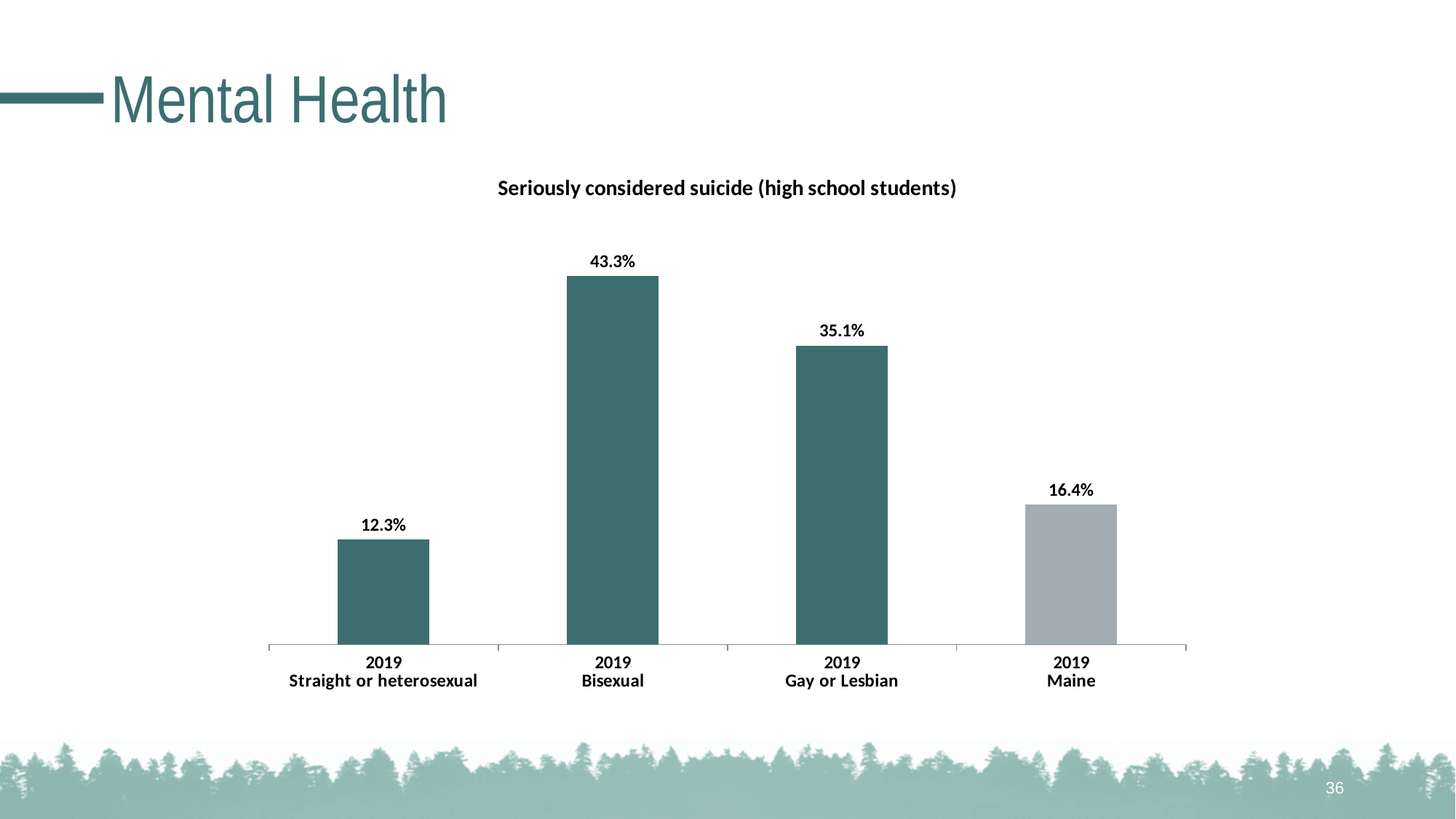
Which category has the highest value? Bisexual What is the difference between the Bisexual and Gay or Lesbian values? 8.2% How many bars are shown in the chart? 4 What is the value for Straight or heterosexual students? 12.3% What kind of chart is shown on the slide? Bar chart What is the value for Maine overall? 16.4% Which is larger, the value for Gay or Lesbian or the value for Maine? Gay or Lesbian What is the difference between the Maine value and the Straight or heterosexual value? 4.1% What is the value for Bisexual students in the chart? 43.3% What is the title of the chart? Seriously considered suicide (high school students) What is the value for Gay or Lesbian students? 35.1% Which category has the lowest value? Straight or heterosexual